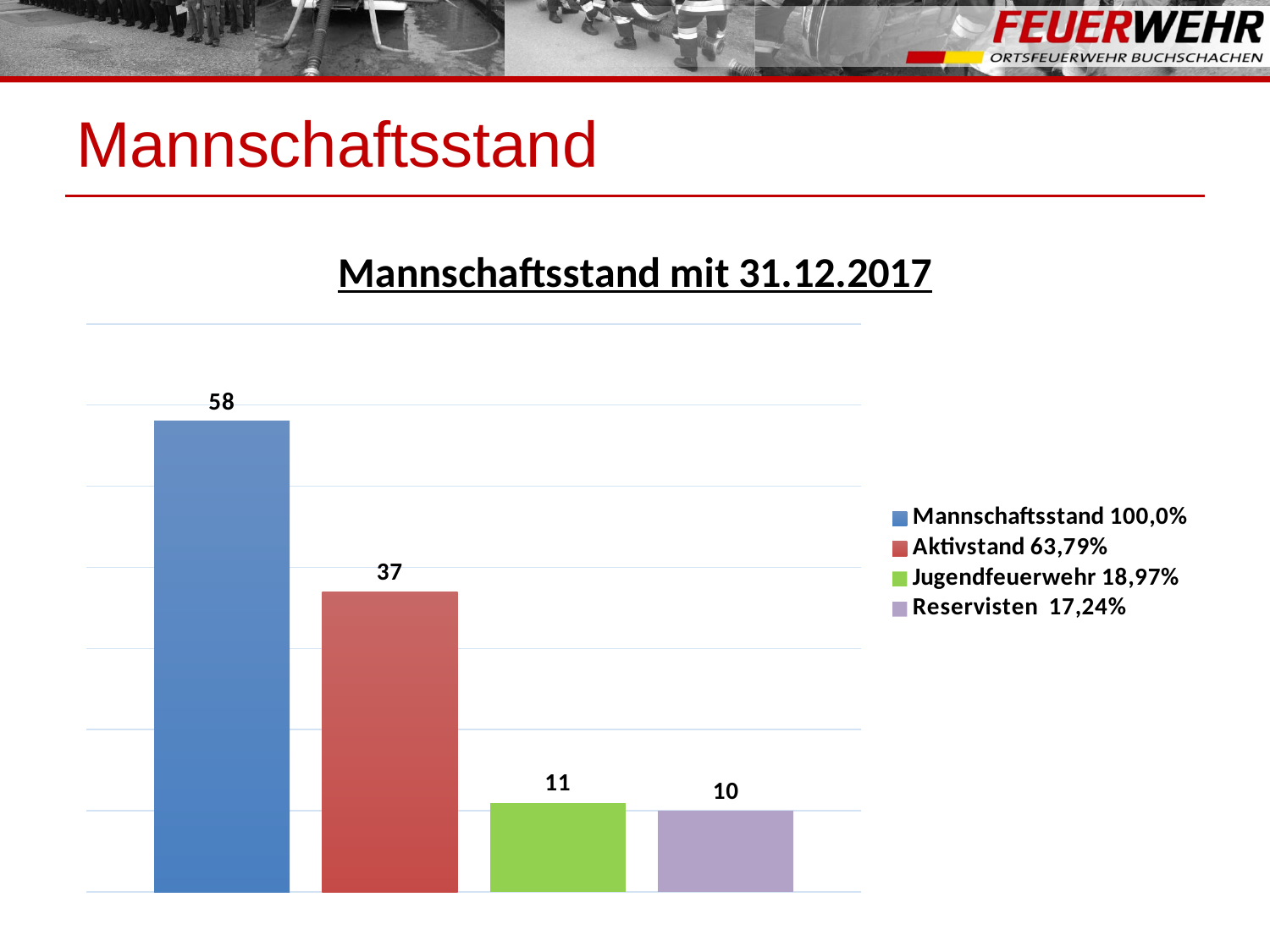
What is the value for Mannschaftsstand? 58 How many bars are shown in the chart? 4 Which is larger, the value for Aktivstand or the value for Jugendfeuerwehr? Aktivstand What kind of chart is shown on the slide? Bar chart What is the value for Aktivstand? 37 How many entries does the legend list? 4 Which category has the highest value? Mannschaftsstand What is the value for Jugendfeuerwehr? 11 Which category has the lowest value? Reservisten What is the value for Reservisten? 10 What is the title of the chart? Mannschaftsstand mit 31.12.2017 What is the difference between the values for Mannschaftsstand and Aktivstand? 21